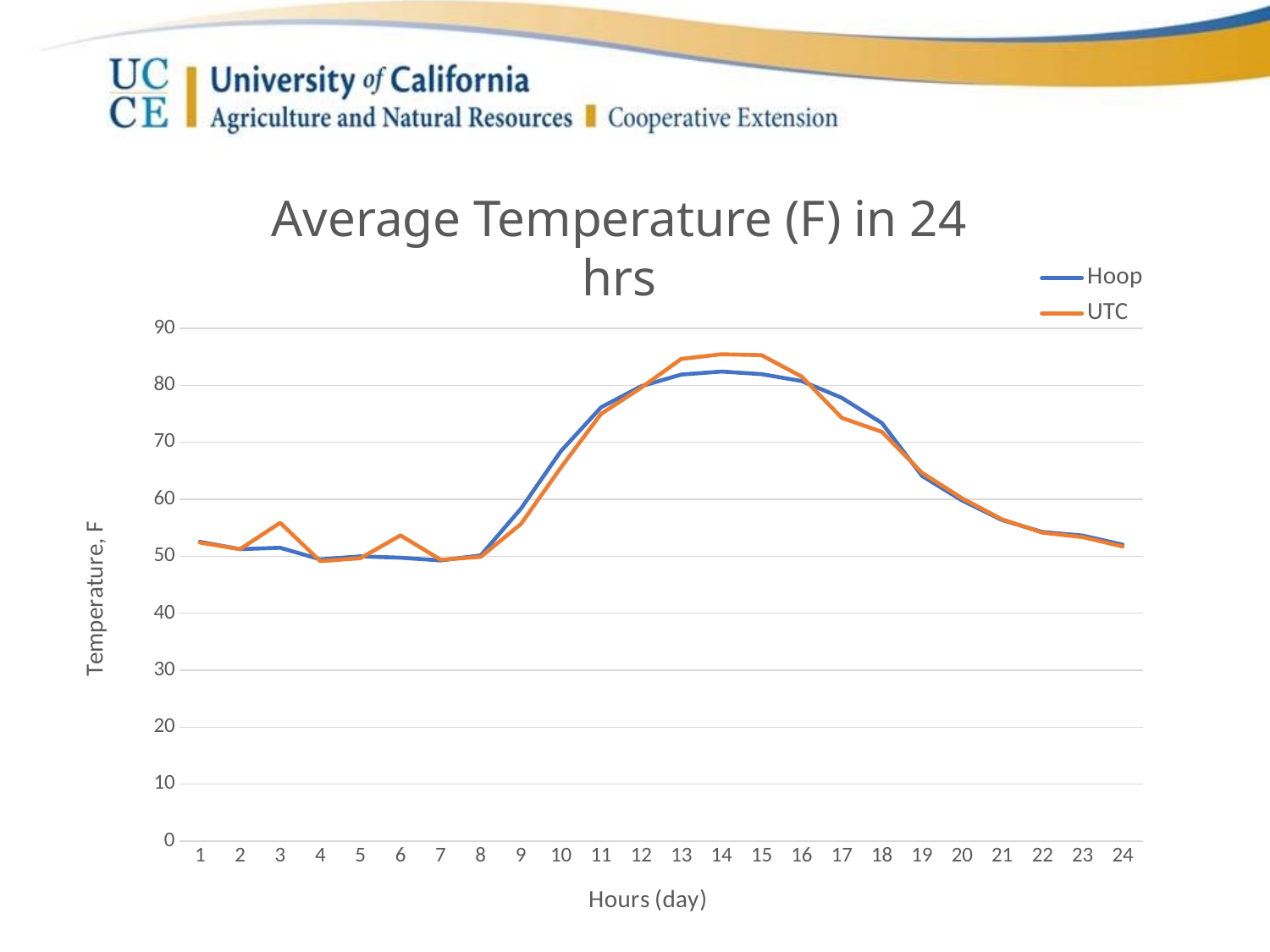
How many hours are plotted along the x axis? 24 Is the Hoop value at hour 1 greater or less than 60? less At hour 3, which series has the higher temperature, Hoop or UTC? UTC At hour 17, which series has the higher temperature, Hoop or UTC? Hoop How many series does the legend list? 2 What kind of chart is shown on the slide? line chart Is the Hoop value at hour 19 greater or less than 70? less What is the label of the y axis? Temperature, F What is the title of the chart? Average Temperature (F) in 24 hrs Is the Hoop value at hour 14 greater or less than 80? greater Do the temperatures rise or fall between hour 8 and hour 14? rise